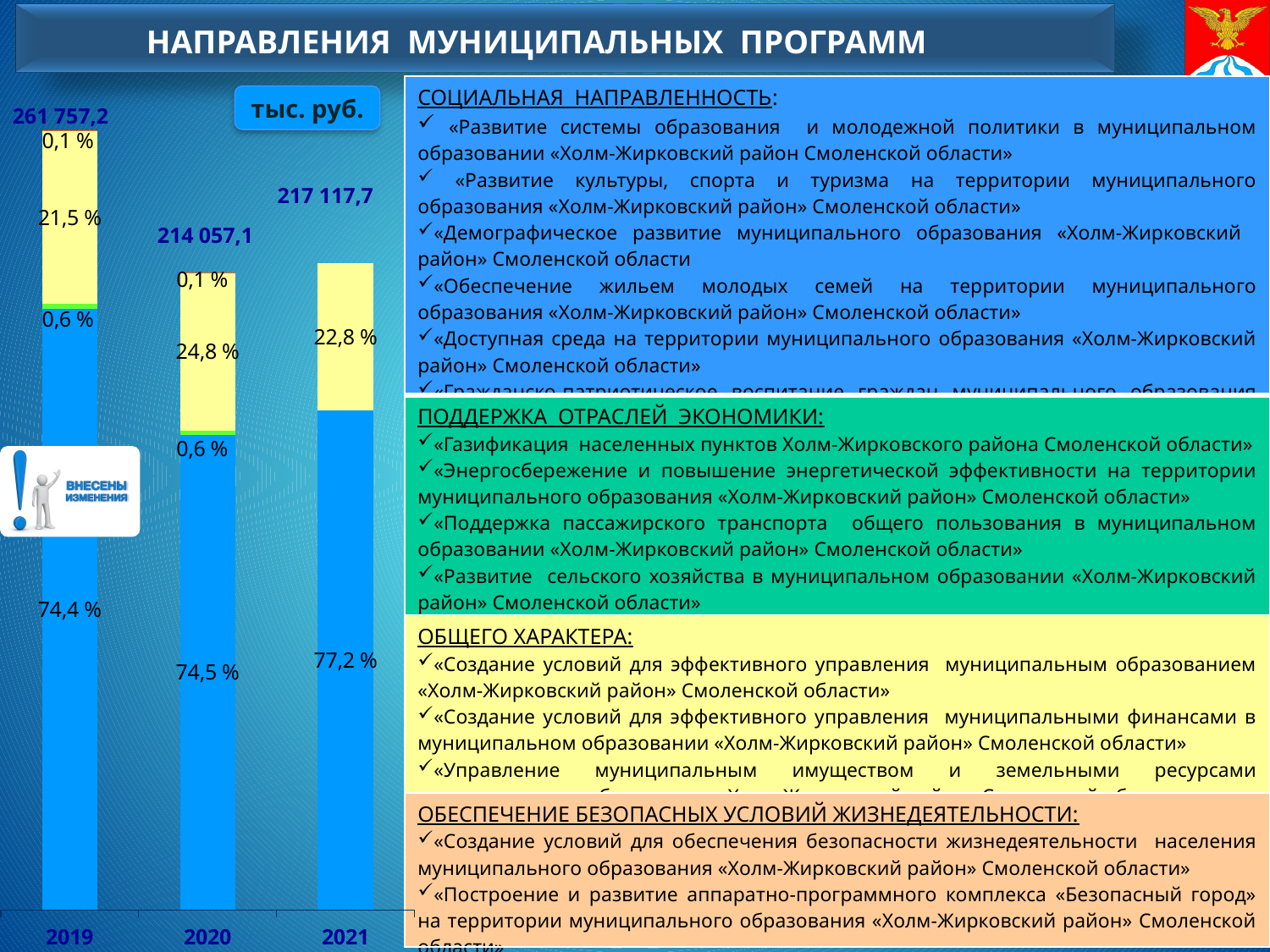
What unit is indicated in the box above the chart? тыс. руб. What total value (тыс. руб.) is labelled above the 2019 bar? 261 757,2 Which is larger: the blue segment share in 2019 or in 2021? 2021 Which year has the lowest total value in the chart? 2020 Which year has the highest total value in the chart? 2019 What percentage is shown for the green segment of the 2019 bar? 0,6 % What total value (тыс. руб.) is labelled above the 2021 bar? 217 117,7 How many years (categories) are shown on the x axis of the chart? 3 What total value (тыс. руб.) is labelled above the 2020 bar? 214 057,1 What percentage is shown for the yellow segment of the 2020 bar? 24,8 % What percentage is shown for the blue (bottom) segment of the 2021 bar? 77,2 % What type of chart is shown on the left of the slide? stacked bar chart